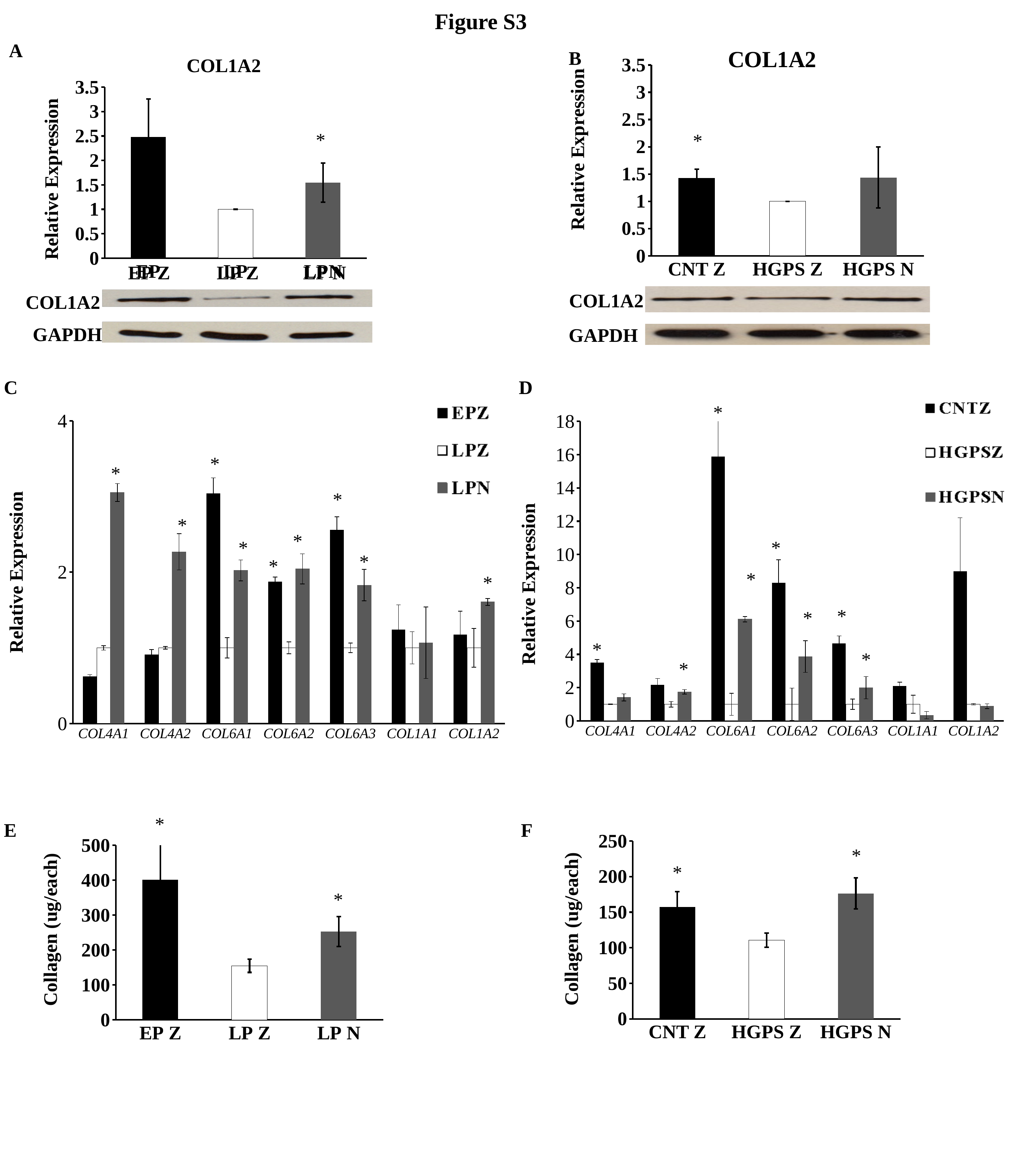
In panel B (COL1A2), is the relative expression for HGPS Z greater or less than 1.5? less In panel F (Collagen, CNT Z / HGPS Z / HGPS N), which category has the lowest collagen value? HGPS Z In panel D, how many series does the legend list? 3 In panel C, for COL4A1, which is larger: the EPZ bar or the LPN bar? LPN What kind of chart is shown in panel A (COL1A2)? bar chart In panel D, is the CNTZ value for COL6A1 greater or less than 14? greater In panel F, is the collagen value for HGPS N greater or less than 150? greater In panel C, how many genes are shown on the x axis? 7 In panel E (Collagen, EP Z / LP Z / LP N), which category has the highest collagen value? EP Z In panel C, which gene has the highest LPN bar? COL4A1 In panel D, which gene has the highest CNTZ bar? COL6A1